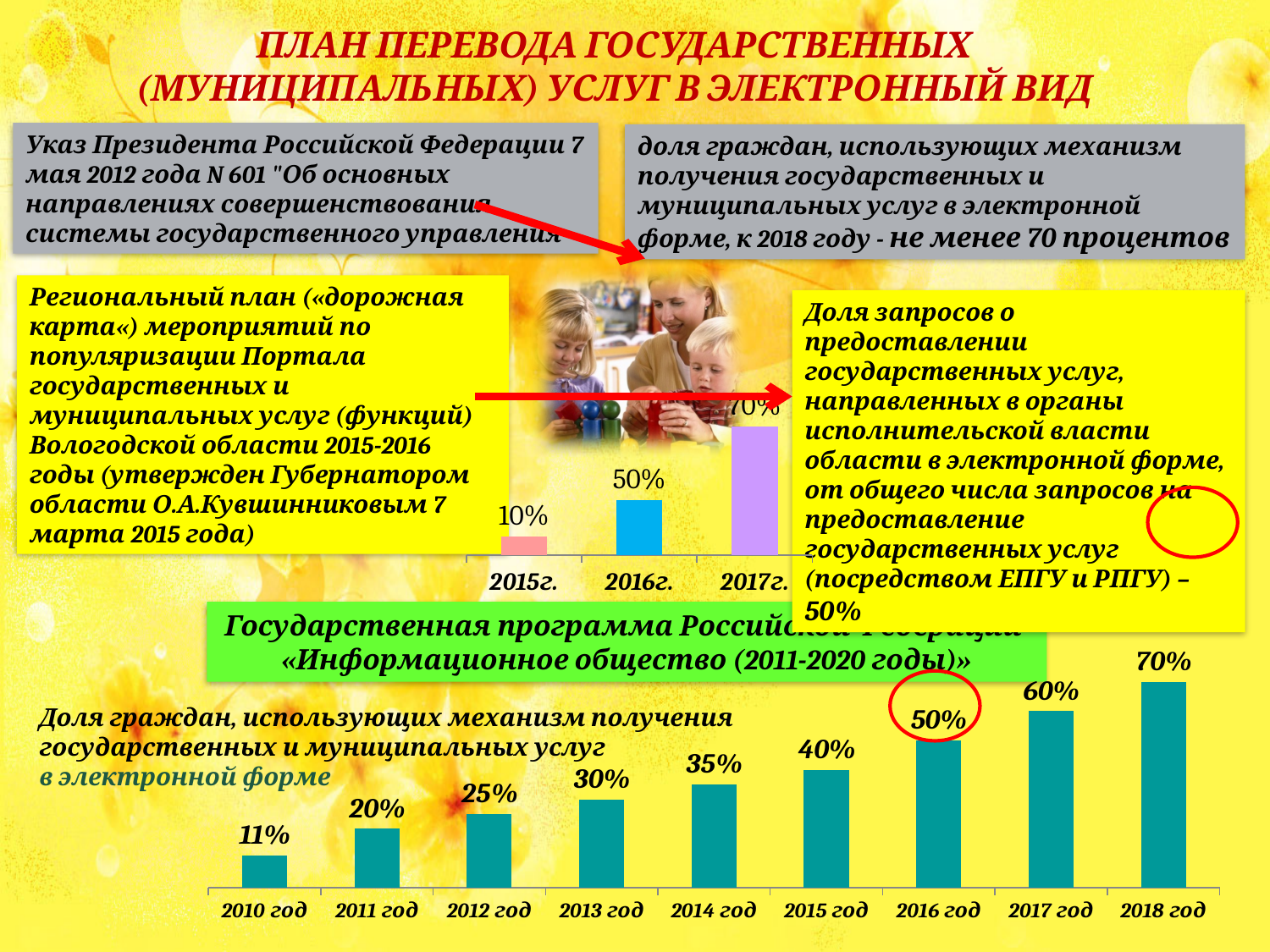
On the small chart in the middle of the slide, what is the value for 2015г.? 10% On the bottom chart, which year has the lowest value? 2010 год On the bottom chart, what is the difference between the values for 2017 год and 2016 год? 10% How many years are shown on the bottom chart? 9 On the bottom chart, which year has the highest value? 2018 год What kind of chart is the bottom chart? bar chart On the bottom chart, what is the value for 2014 год? 35% On the small chart in the middle of the slide, what is the value for 2016г.? 50% On the bottom chart, which is larger: the value for 2013 год or the value for 2015 год? 2015 год On the bottom chart, what is the value for 2018 год? 70% On the bottom chart, what is the value for 2010 год? 11% Do the values on the bottom chart rise or fall from 2010 год to 2018 год? rise